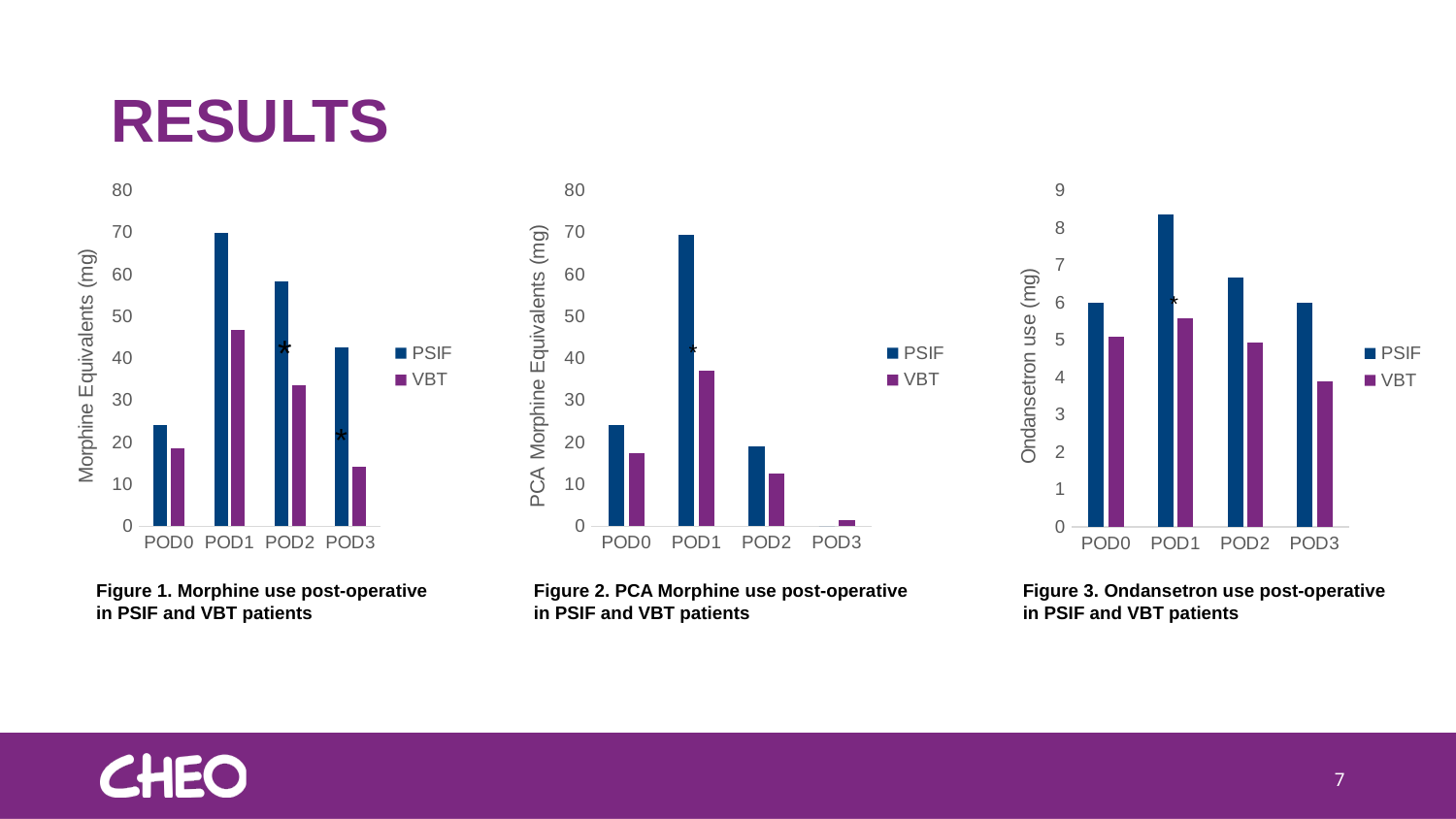
What kind of chart is Figure 3 (Ondansetron use post-operative)? bar chart In Figure 1 (Morphine use post-operative), is the VBT value for POD3 greater or less than 20? less In Figure 3 (Ondansetron use post-operative), which post-operative day has the highest PSIF value? POD1 In Figure 2 (PCA Morphine use post-operative), is the PSIF value for POD1 greater or less than 60? greater In Figure 3 (Ondansetron use post-operative), do the VBT values rise or fall from POD1 to POD3? fall In Figure 2 (PCA Morphine use post-operative), how many series does the legend list? 2 In Figure 1 (Morphine use post-operative), which post-operative day has the highest PSIF value? POD1 In Figure 1 (Morphine use post-operative), is the PSIF value for POD1 greater or less than 60? greater In Figure 2 (PCA Morphine use post-operative), which post-operative day has the lowest VBT value? POD3 In Figure 1 (Morphine use post-operative), which is larger at POD2, the PSIF value or the VBT value? PSIF How many post-operative day categories are shown on the x axis of Figure 1 (Morphine use post-operative)? 4